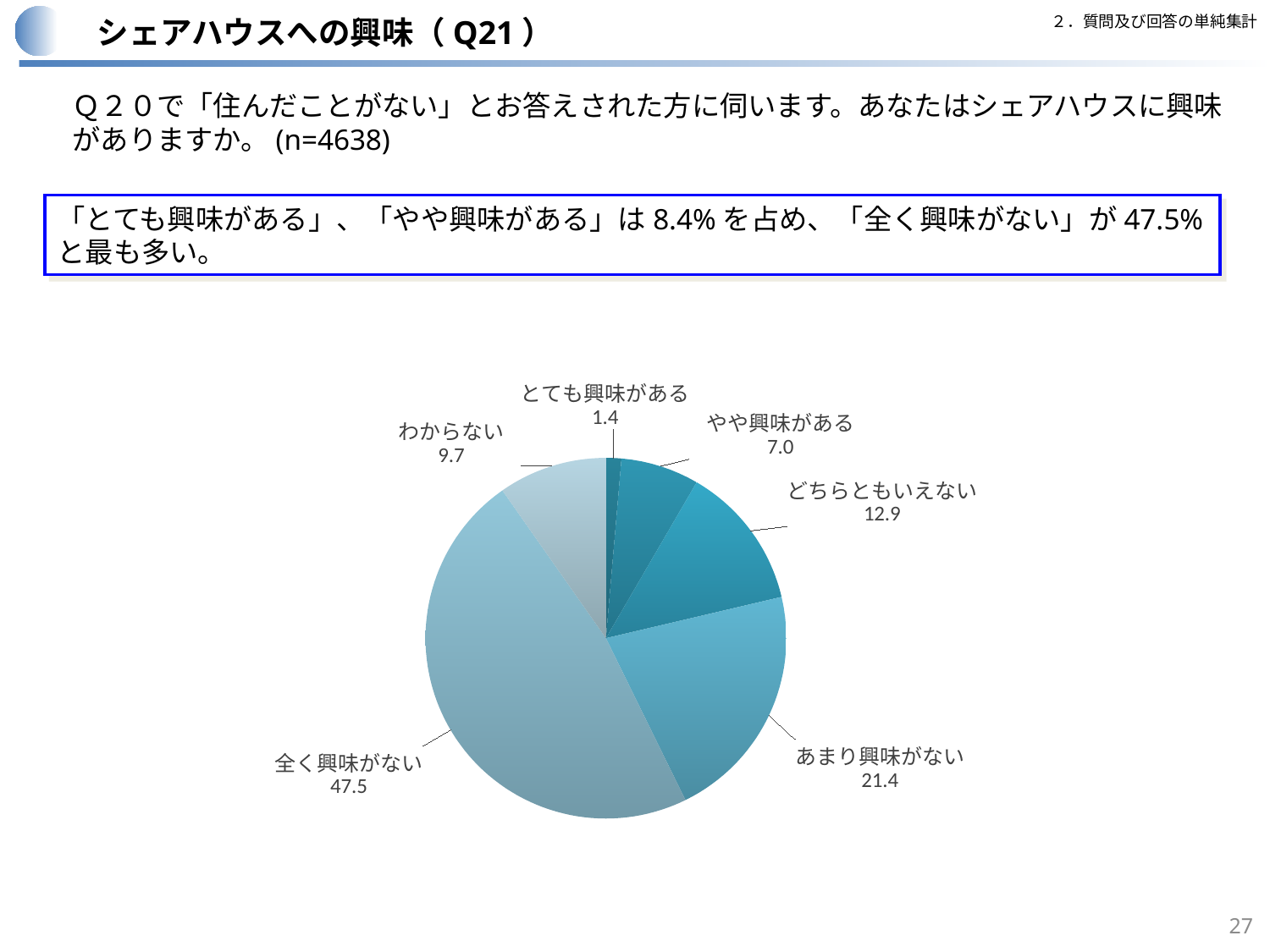
What is the value for とても興味がある? 1.4 How many categories are shown in the pie chart? 6 What is the value for あまり興味がない? 21.4 What is the value for 全く興味がない? 47.5 What is the combined value of とても興味がある and やや興味がある? 8.4 What is the value for わからない? 9.7 Which category has the smallest slice? とても興味がある Which category has the largest slice? 全く興味がない Which is larger, the value for やや興味がある or the value for わからない? わからない What is the difference between the values for 全く興味がない and あまり興味がない? 26.1 What type of chart is shown on the slide? pie chart What is the value for どちらともいえない? 12.9